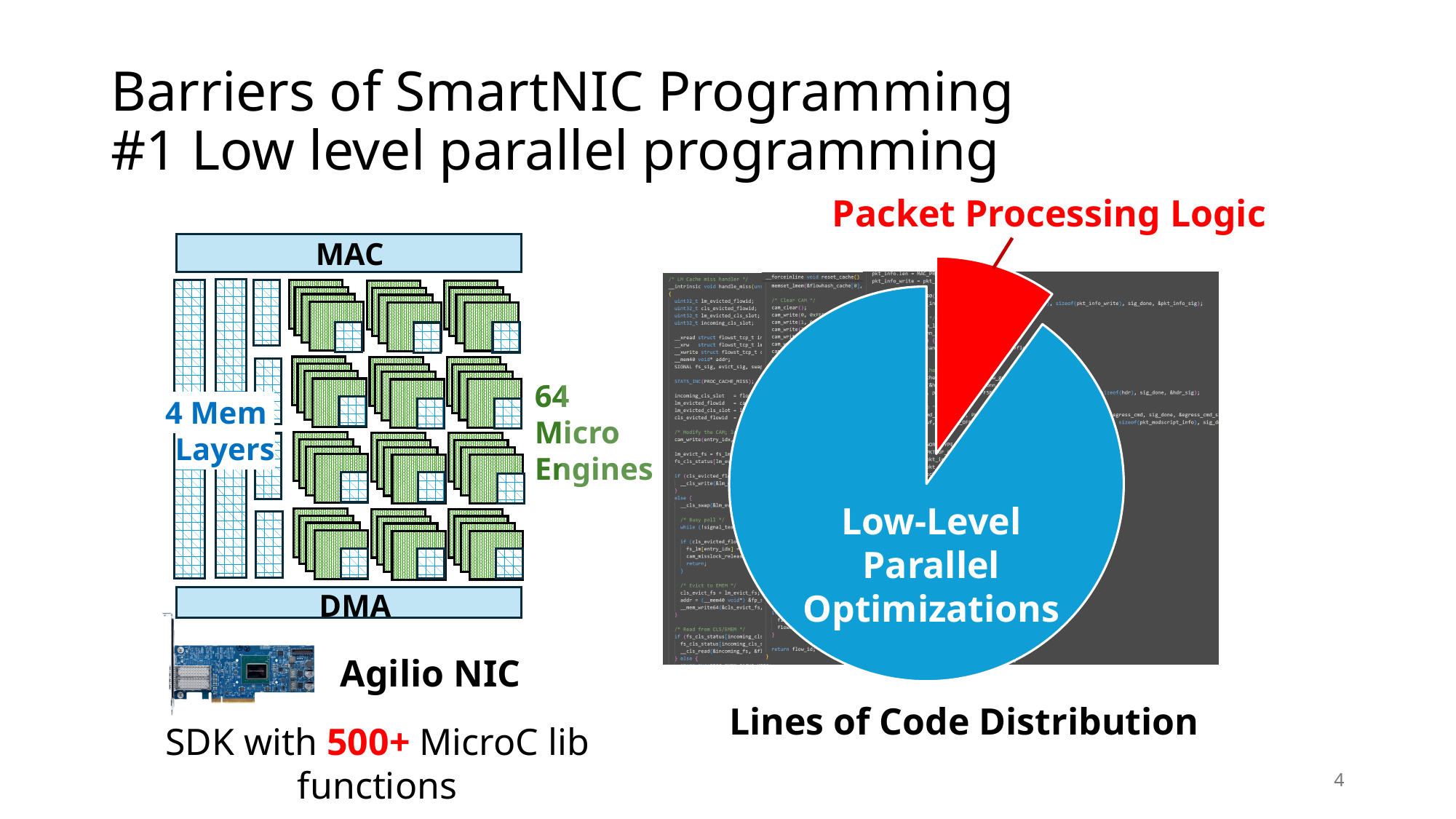
Does the Low-Level Parallel Optimizations slice take up more or less than half of the pie chart? more Which slice of the pie chart is the largest? Low-Level Parallel Optimizations In the pie chart, which slice is larger: Packet Processing Logic or Low-Level Parallel Optimizations? Low-Level Parallel Optimizations What kind of chart is shown on the right side of the slide? pie chart Which slice of the pie chart is the smallest? Packet Processing Logic What colour is the Packet Processing Logic slice in the pie chart? red How many slices does the pie chart have? 2 What is the title of the pie chart? Lines of Code Distribution